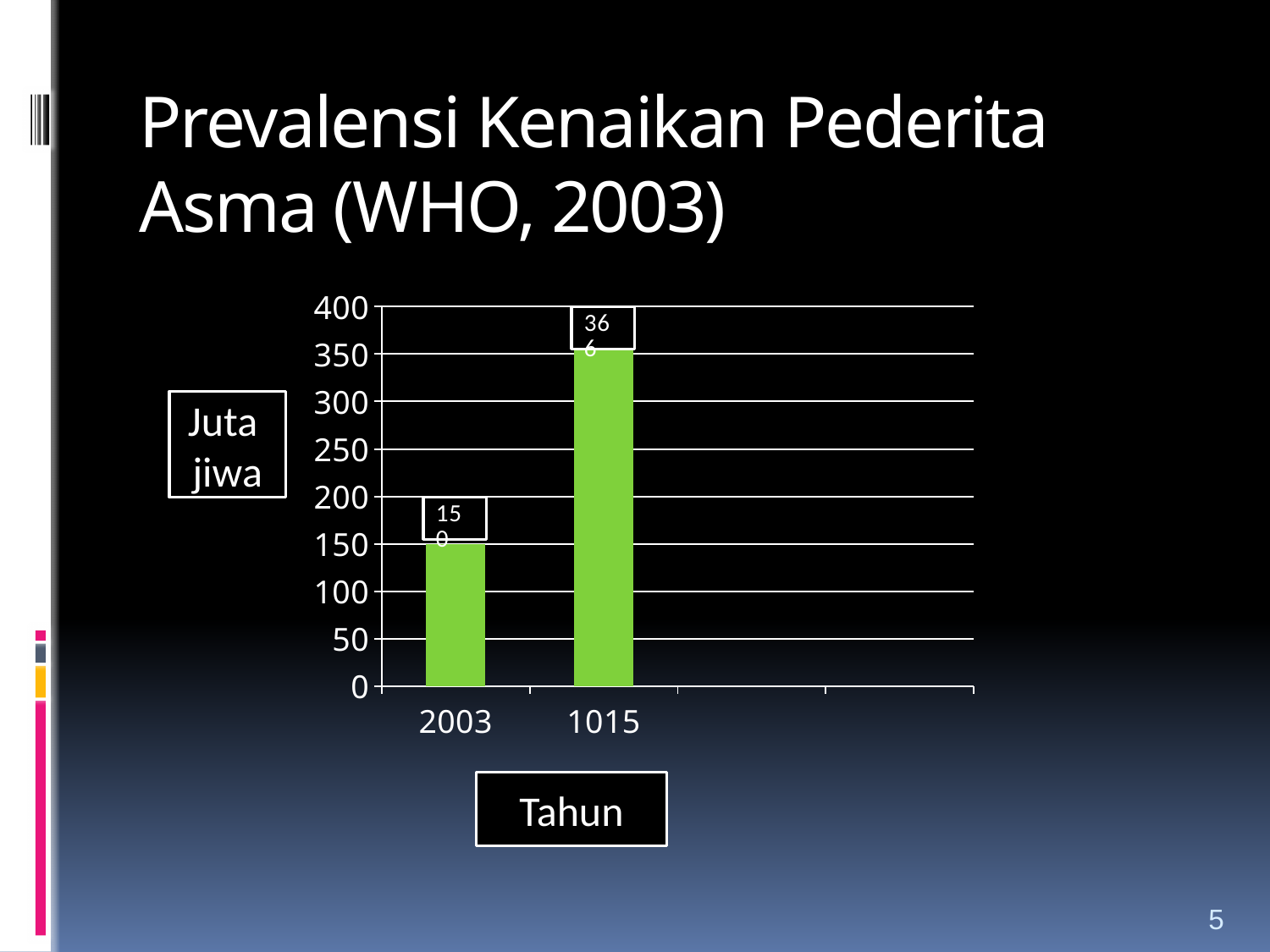
Is the value for 2003 greater or less than 200? less Do the values rise or fall from 2003 to 1015? rise What is the value for 1015? 366 What is the difference between the values for 1015 and 2003? 216 What kind of chart is shown on the slide? bar chart Which year has the highest value? 1015 How many bars are plotted in the chart? 2 What is the value for 2003? 150 Is the value for 1015 greater or less than 300? greater What label is shown next to the vertical axis of the chart? Juta jiwa Which is larger, the value for 2003 or the value for 1015? 1015 Which year has the lowest value? 2003